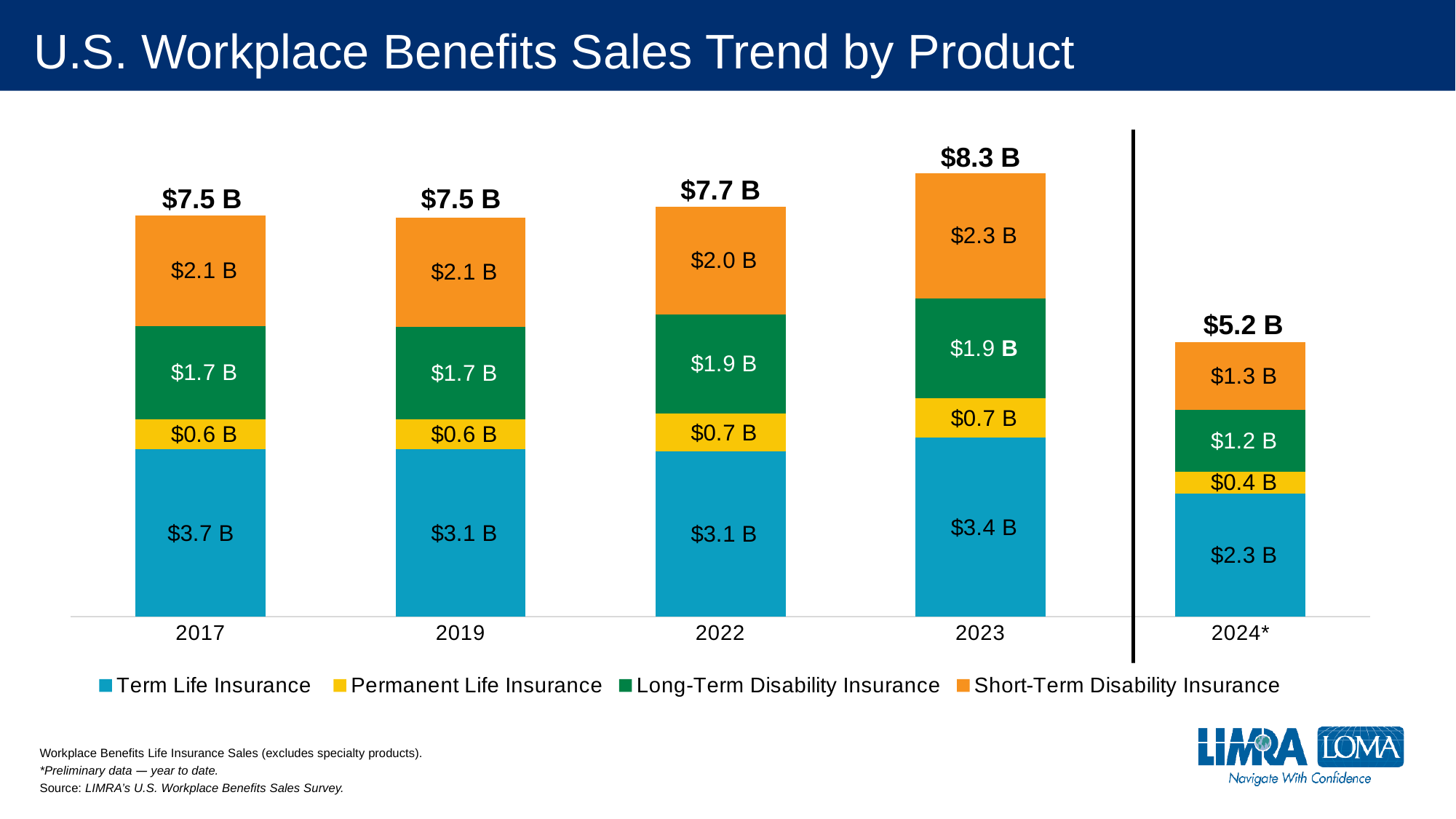
How many series does the legend list? 4 What is the Long-Term Disability Insurance value for 2022? $1.9 B Which year has the highest total sales? 2023 Which is larger, the Short-Term Disability Insurance value for 2022 or for 2023? 2023 What is the Term Life Insurance value for 2017? $3.7 B What is the difference between the Term Life Insurance values for 2017 and 2019? $0.6 B What is the Short-Term Disability Insurance value for 2023? $2.3 B What is the total of the stacked bar for 2023? $8.3 B How many years are shown on the x axis? 5 What is the Permanent Life Insurance value for 2024*? $0.4 B What kind of chart is shown on the slide? Stacked bar chart Which year has the lowest total sales? 2024*